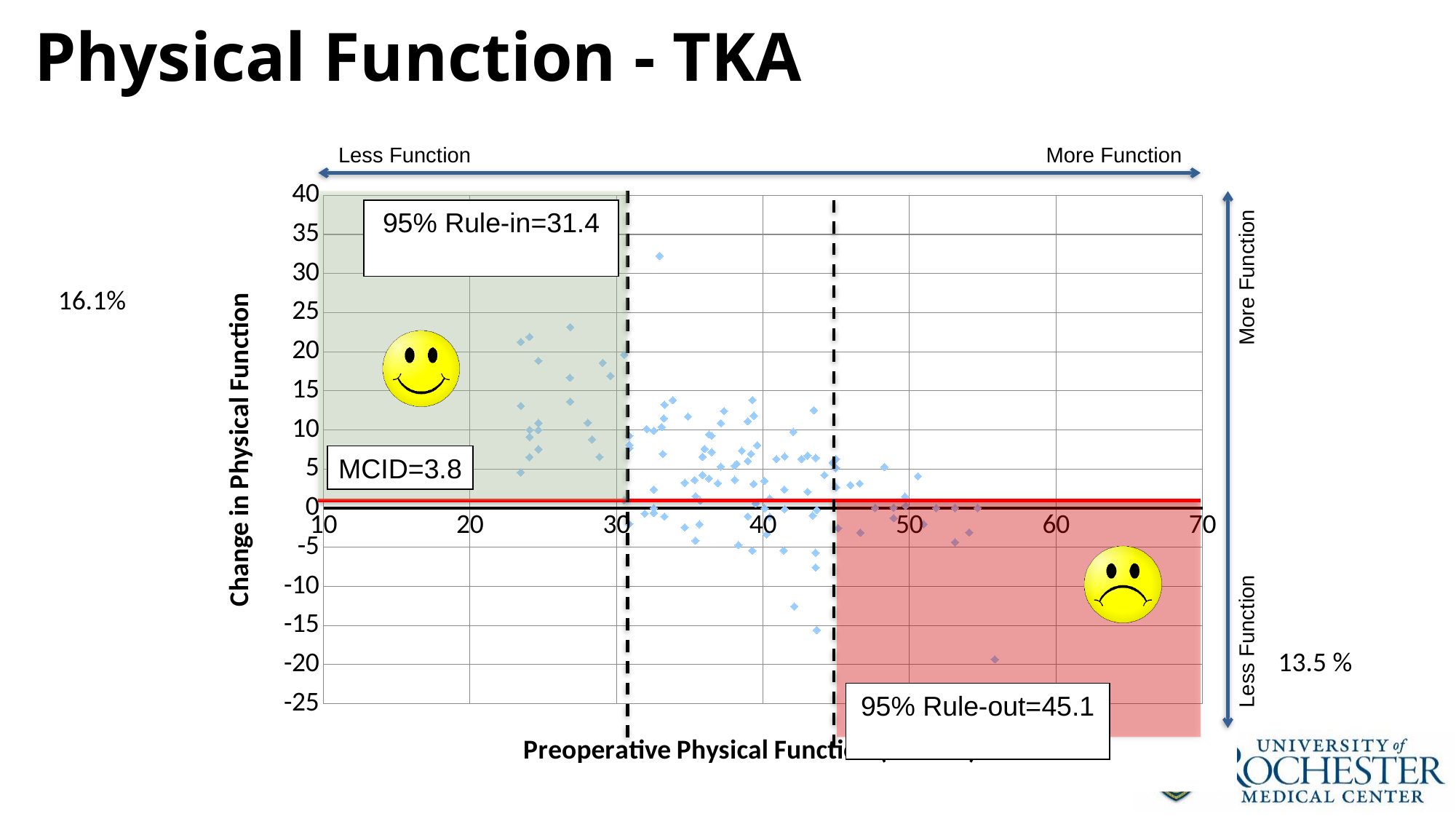
What value is given for the 95% Rule-out on the chart? 45.1 What is the maximum value shown on the horizontal axis? 70 Which is larger, the 95% Rule-out value or the 95% Rule-in value? 95% Rule-out What percentage is shown next to the green (upper-left) region of the chart? 16.1% Is the lowest plotted change in physical function greater or less than -15? less What value is given for the 95% Rule-in on the chart? 31.4 Is the highest plotted change in physical function greater or less than 30? greater What percentage is shown next to the red (lower-right) region of the chart? 13.5 % What kind of chart is shown on the slide? Scatter plot What is the title of the slide containing the chart? Physical Function - TKA What is the label of the vertical axis of the chart? Change in Physical Function What is the MCID value shown on the chart? 3.8